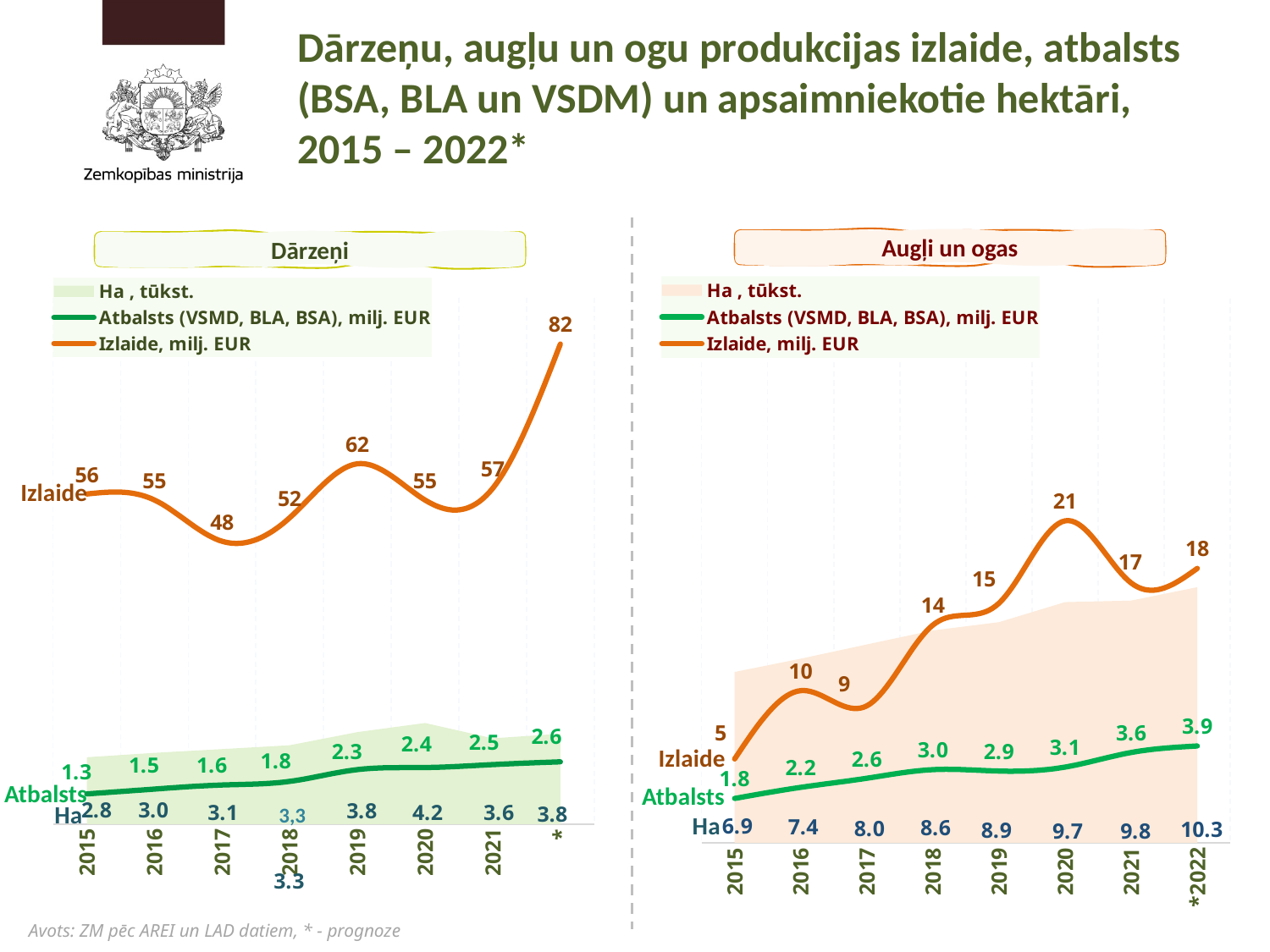
In the Augļi un ogas chart, what is the difference between the Atbalsts values for 2022 and 2015? 2.1 In the Dārzeņi chart, what is the Atbalsts value for 2021? 2.5 How many series does the legend of the Dārzeņi chart list? 3 How many years are shown on the x axis of the Augļi un ogas chart? 8 In the Augļi un ogas chart, what is the Izlaide value for 2020? 21 In the Dārzeņi chart, what is the Izlaide value for 2019? 62 In the Augļi un ogas chart, what is the Ha value for 2015? 6.9 In the Dārzeņi chart, which year has the highest Ha value? 2020 In the Dārzeņi chart, what is the difference between the Izlaide values for 2022* and 2021? 25 In the Augļi un ogas chart, does the Ha value rise or fall from 2015 to 2022? rise In the Augļi un ogas chart, which is larger, the Izlaide value for 2016 or for 2017? 2016 In the Dārzeņi chart, which year has the lowest Izlaide value? 2017